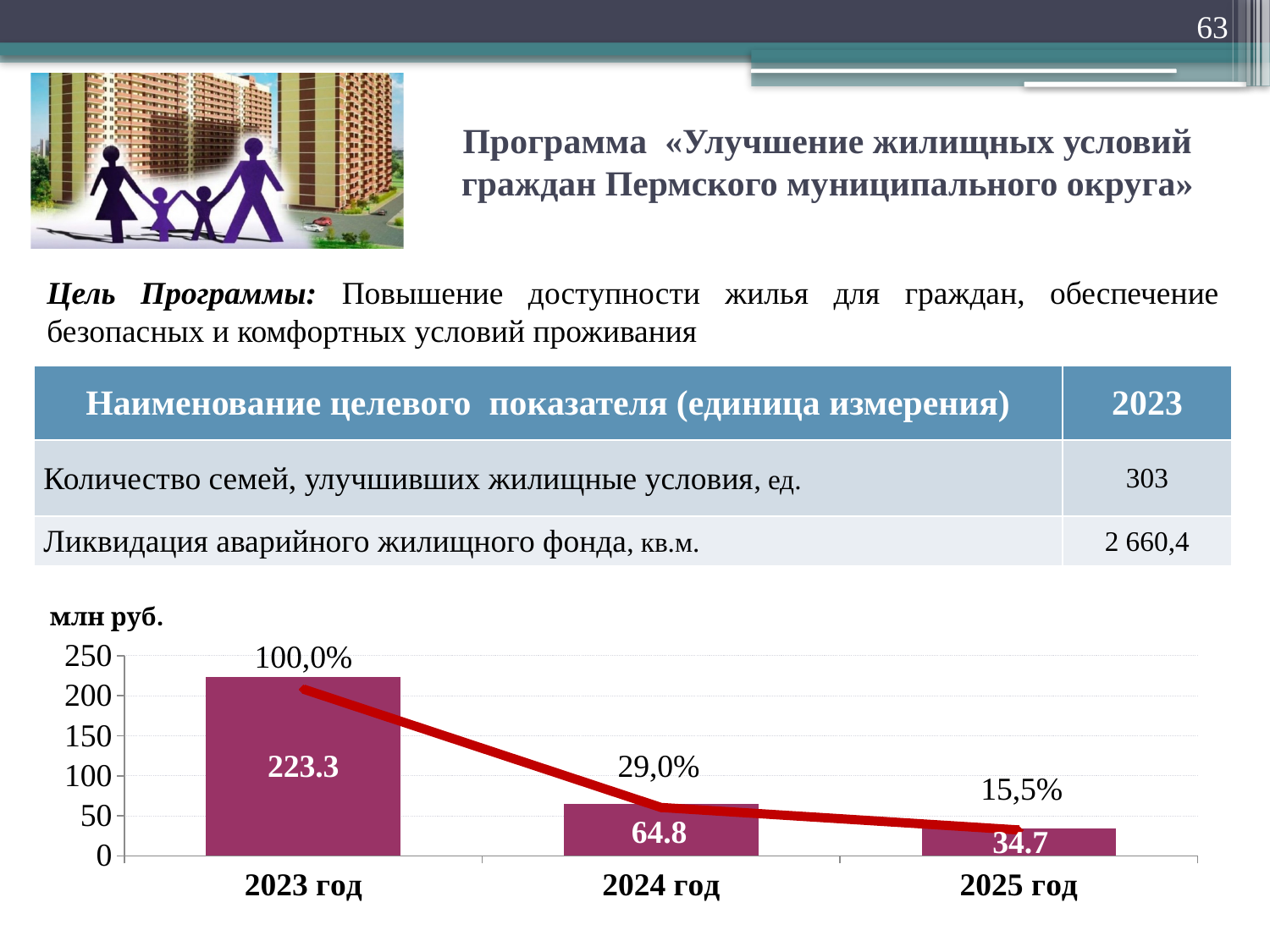
Which is larger, the bar value for 2024 год or for 2025 год? 2024 год What is the value for 2023 год in the bar chart? 223.3 What is the value for 2024 год in the bar chart? 64.8 What percentage is shown above the 2024 год bar? 29,0% What is the difference between the bar values for 2023 год and 2024 год? 158.5 What unit is written above the chart's vertical axis? млн руб. What is the value for 2025 год in the bar chart? 34.7 Do the bar values rise or fall from 2023 год to 2025 год? fall What percentage is shown above the 2025 год bar? 15,5% Which year has the highest bar value? 2023 год How many years are shown on the x axis of the chart? 3 Which year has the lowest bar value? 2025 год